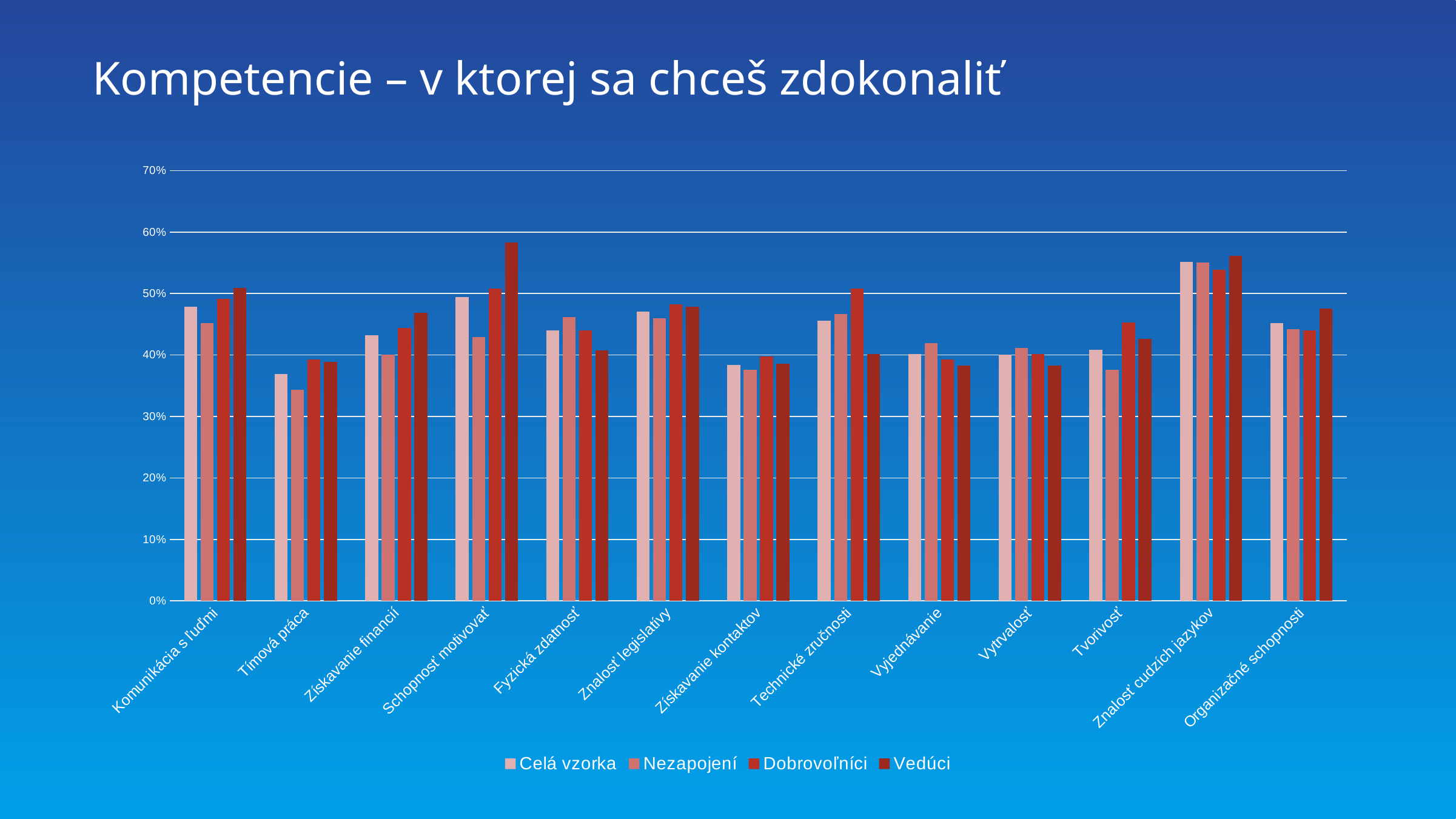
In Schopnosť motivovať, which is larger: the value for Vedúci or the value for Nezapojení? Vedúci Is the value for Vedúci in Schopnosť motivovať greater or less than 50%? greater Is the value for Celá vzorka in Znalosť cudzích jazykov greater or less than 50%? greater Which series are listed in the legend? Celá vzorka, Nezapojení, Dobrovoľníci, Vedúci How many competency categories are shown on the x axis? 13 What kind of chart is shown on the slide? bar chart What is the title of the chart on the slide? Kompetencie – v ktorej sa chceš zdokonaliť For the Celá vzorka series, which category has the highest value? Znalosť cudzích jazykov Which category and series has the single tallest bar in the chart? Vedúci, Schopnosť motivovať How many series does the legend list? 4 Is the value for Celá vzorka in Tímová práca greater or less than 40%? less